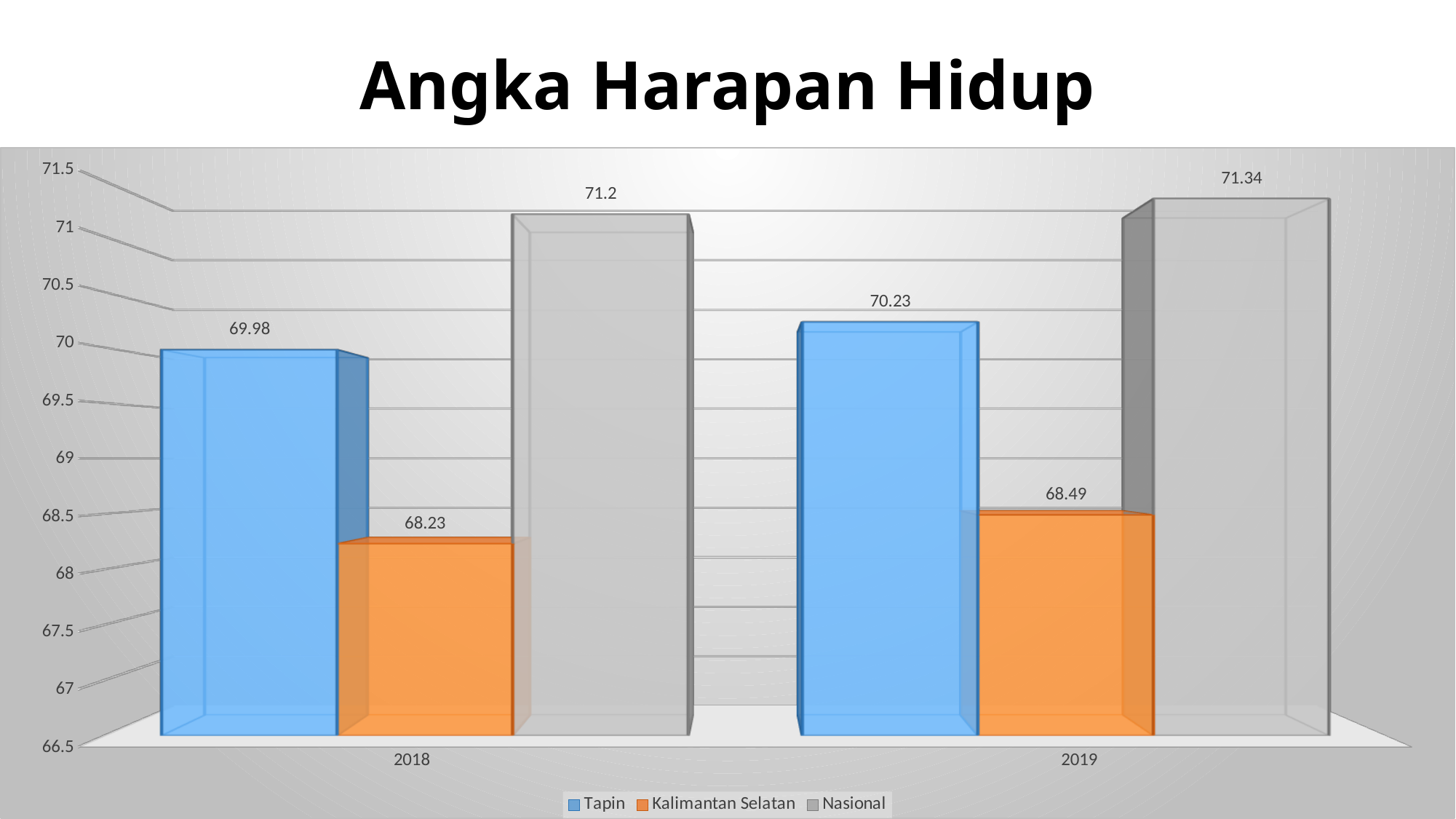
How many series does the legend list? 3 Which series has the lowest value in 2018? Kalimantan Selatan Does the Tapin value rise or fall from 2018 to 2019? Rise What is the value for Nasional in 2019? 71.34 What is the difference between the Nasional and Tapin values in 2018? 1.22 What kind of chart is shown on the slide? Bar chart Which is larger, the Tapin value in 2019 or the Kalimantan Selatan value in 2019? Tapin What is the value for Kalimantan Selatan in 2019? 68.49 What is the value for Tapin in 2018? 69.98 Which series has the highest value in 2019? Nasional What is the value for Nasional in 2018? 71.2 How many categories are shown on the x axis? 2